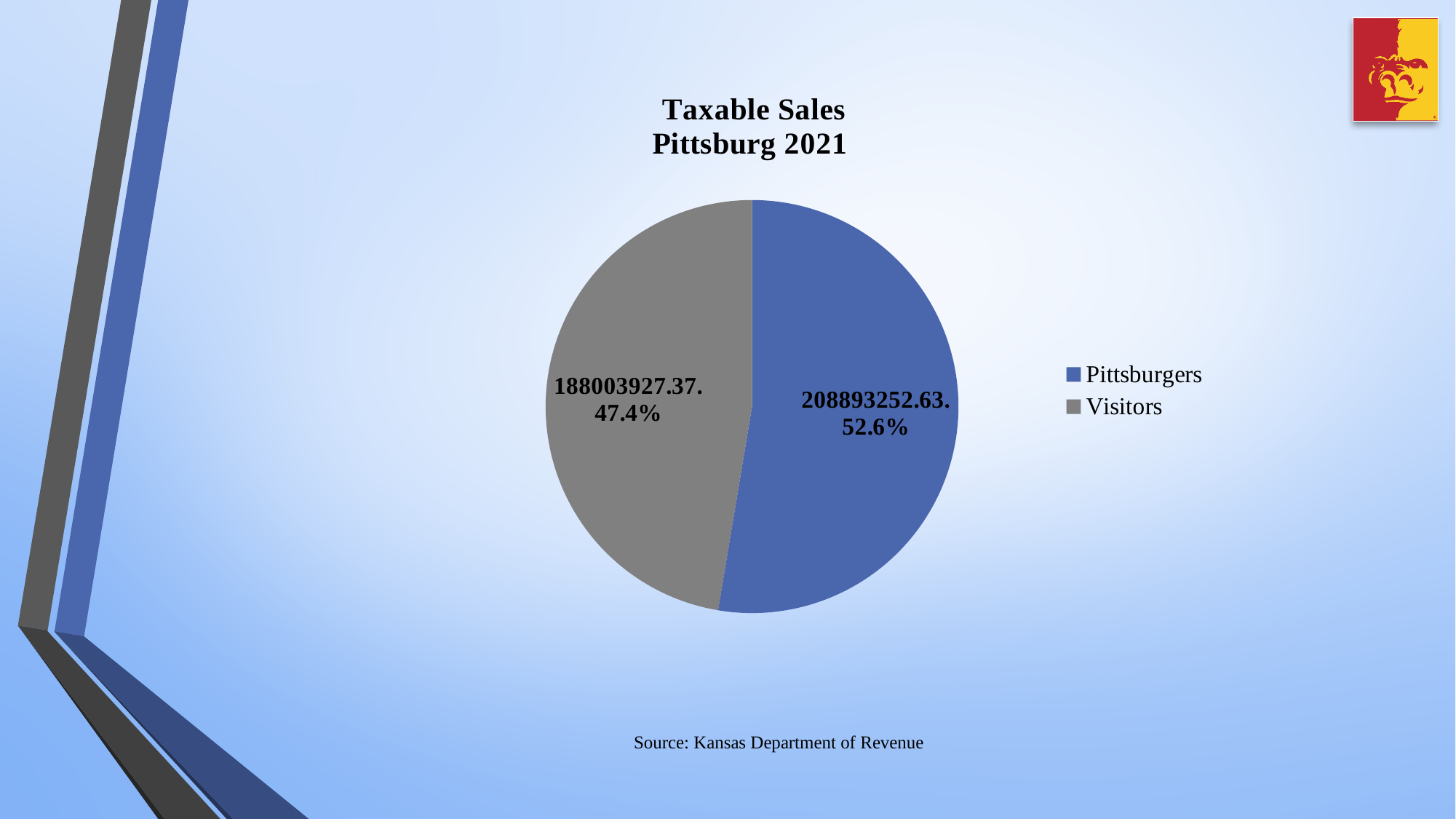
What is the taxable sales value for Visitors? 188003927.37 What is the title of the chart? Taxable Sales Pittsburg 2021 How many entries does the legend list? 2 Which category has the smaller share of taxable sales? Visitors What is the difference between the Pittsburgers and Visitors taxable sales values? 20889325.26 What is the taxable sales value for Pittsburgers? 208893252.63 What type of chart is shown on the slide? pie chart Which colour represents Visitors in the pie chart? gray What share of the pie does the Visitors slice represent? 47.4% How many slices does the pie chart have? 2 Which category has the larger share of taxable sales? Pittsburgers What share of the pie does the Pittsburgers slice represent? 52.6%